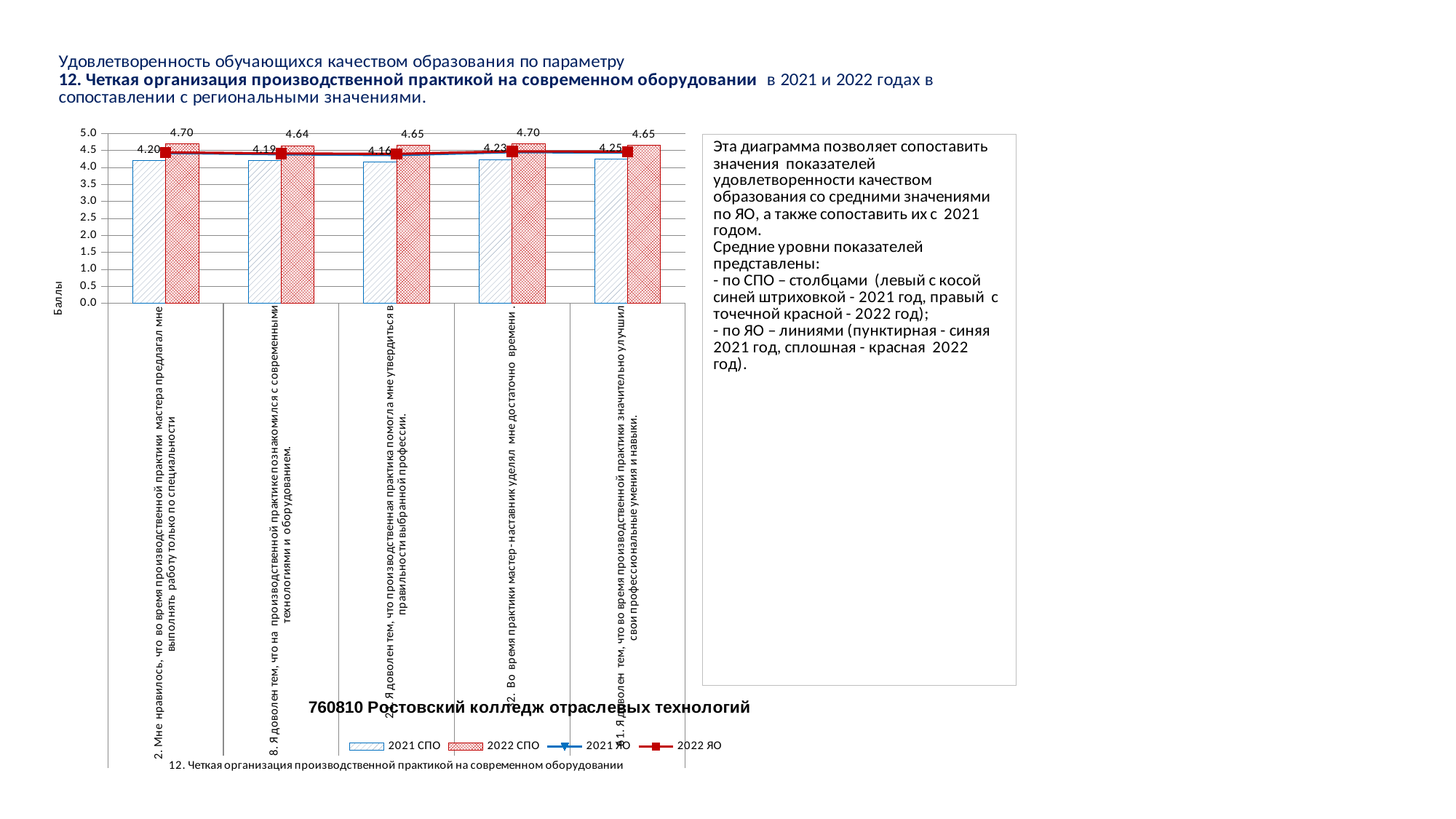
For statement 11 (значительно улучшил свои профессиональные умения и навыки), which is larger: the 2021 СПО value or the 2022 СПО value? 2022 СПО What is the 2022 СПО value for the statement "Во время практики мастер-наставник уделял мне достаточно времени"? 4.70 How many statements (categories) are shown on the x axis of the chart? 5 Is the 2021 СПО value for statement 8 greater or less than 4.0? greater What is the 2021 СПО value for the statement "8. Я доволен тем, что на производственной практике познакомился с современными технологиями и оборудованием"? 4.19 What is the 2021 СПО value for the statement "11. Я доволен тем, что во время производственной практики значительно улучшил свои профессиональные умения и навыки"? 4.25 What is the 2022 СПО value for the statement "8. Я доволен тем, что на производственной практике познакомился с современными технологиями и оборудованием"? 4.64 How many series does the chart legend list? 4 Which statement has the lowest 2021 СПО value? Я доволен тем, что производственная практика помогла мне утвердиться в правильности выбранной профессии (4.16) What kind of chart is shown on the slide? Bar chart combined with line series By how much does the 2022 СПО value exceed the 2021 СПО value for statement 8 (познакомился с современными технологиями и оборудованием)? 0.45 Which statement has the highest 2021 СПО value? Я доволен тем, что во время производственной практики значительно улучшил свои профессиональные умения и навыки (4.25)